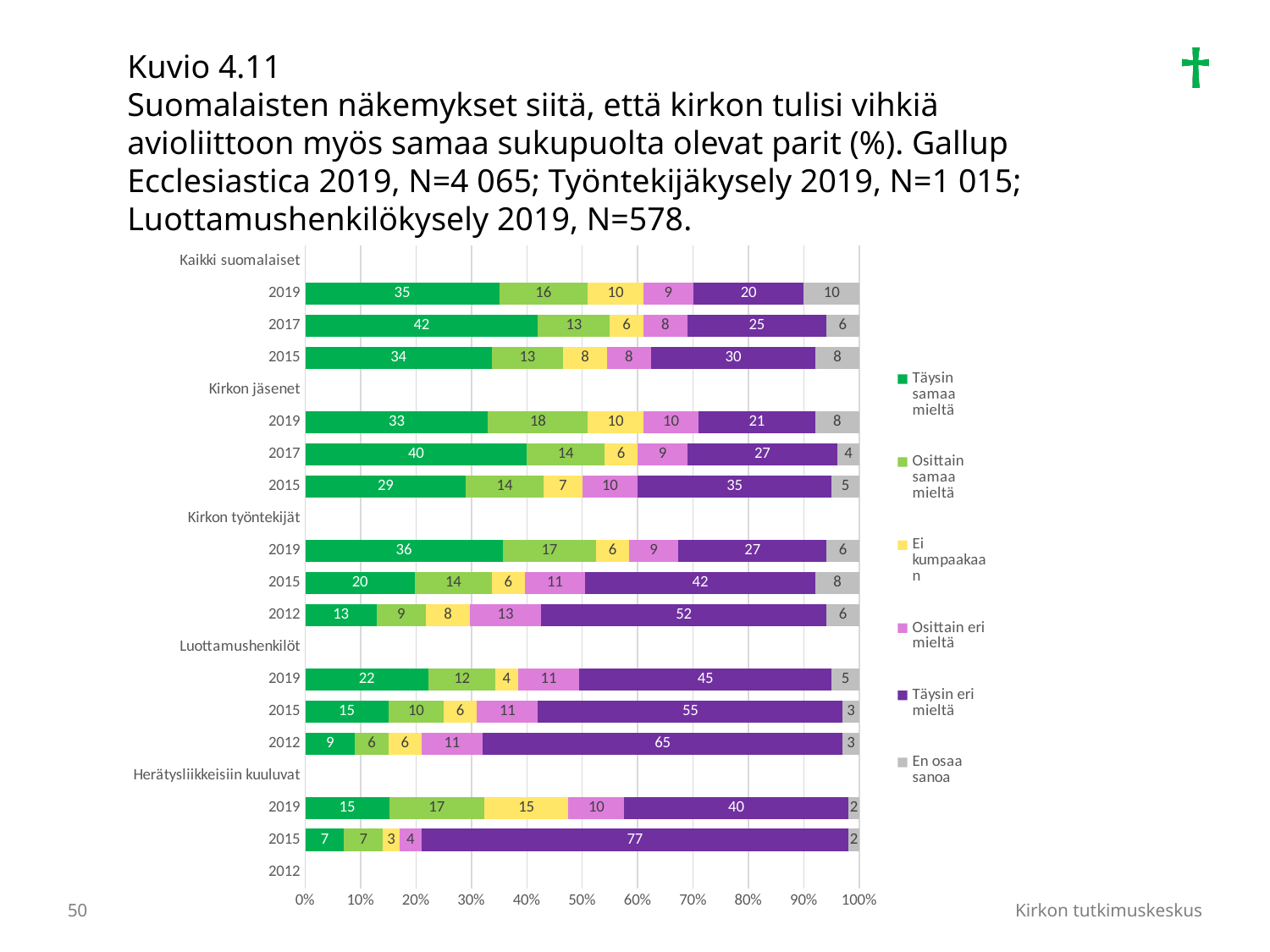
How many series does the legend list? 6 Which legend entry is shown in yellow? Ei kumpaakaan What kind of chart is shown on the slide? stacked bar chart Which year has the highest "Täysin eri mieltä" value among Luottamushenkilöt? 2012 What is the value of "Osittain samaa mieltä" for Kirkon jäsenet in 2019? 18 Which year has the lowest "Täysin samaa mieltä" value among Kirkon työntekijät? 2012 What is the value of "Täysin eri mieltä" for Herätysliikkeisiin kuuluvat in 2015? 77 What is the value of "Täysin samaa mieltä" for Kaikki suomalaiset in 2019? 35 Which is larger: "Täysin eri mieltä" for Kirkon työntekijät in 2015 or for Luottamushenkilöt in 2015? Luottamushenkilöt 2015 What is the value of "En osaa sanoa" for Luottamushenkilöt in 2012? 3 What is the difference between the "Täysin samaa mieltä" values for Kaikki suomalaiset in 2017 and 2019? 7 Which group's 2012 bar has no data shown? Herätysliikkeisiin kuuluvat